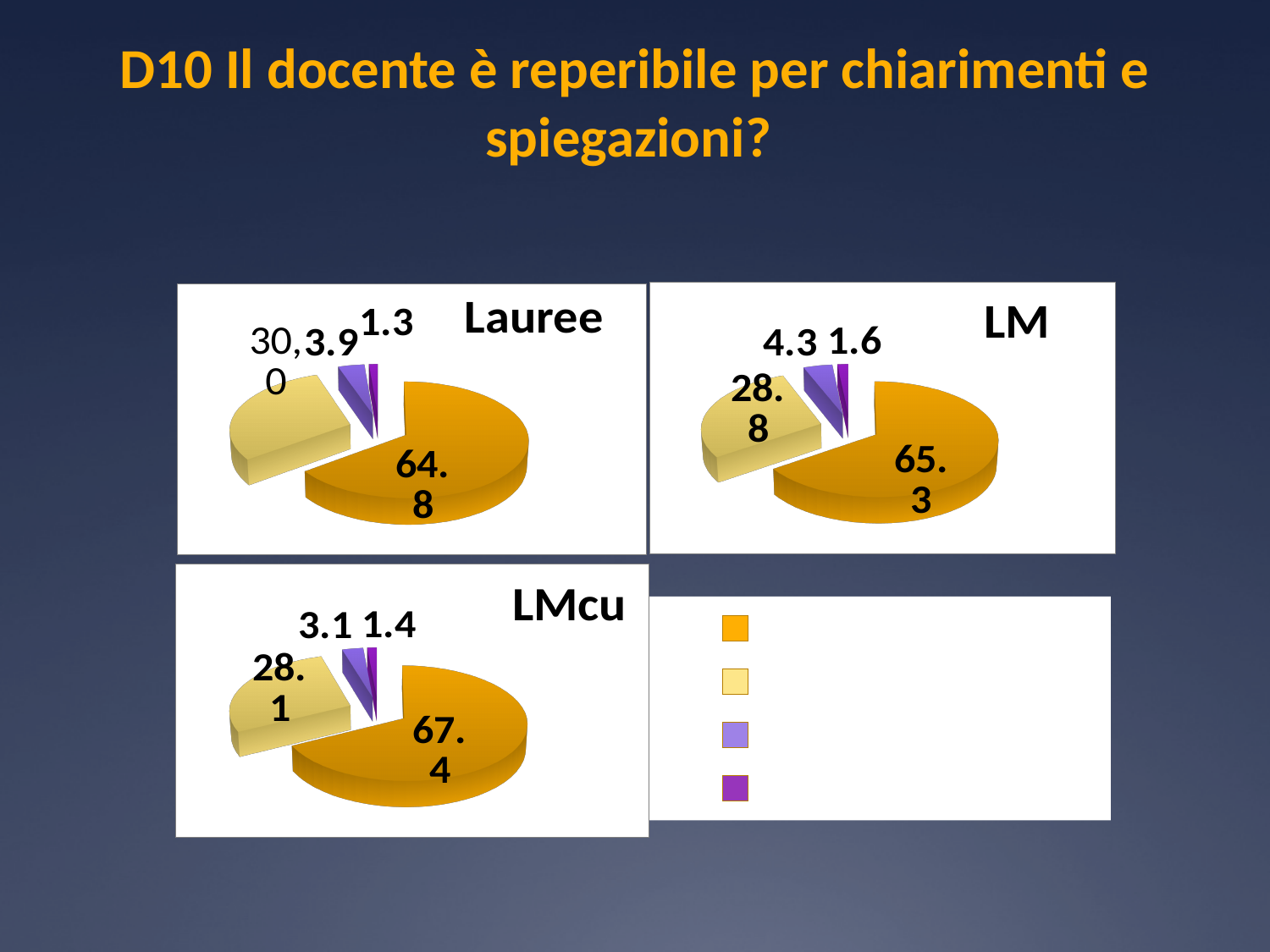
In the LM chart, what is the value of the largest slice? 65.3 In the LMcu chart, what is the value of the smallest slice? 1.4 In the LMcu chart, what is the value of the light yellow slice? 28.1 In the Lauree chart, what is the value of the largest slice? 64.8 In the LM chart, what is the value of the smallest slice? 1.6 How many slices does the LM pie chart have? 4 In the Lauree chart, what is the value of the smallest slice? 1.3 In the LM chart, what is the value of the light yellow slice? 28.8 In the LM chart, what is the difference between the largest slice and the light yellow slice? 36.5 What kind of chart is the Lauree chart? pie chart How many pie charts are shown on the slide? 3 In the LMcu chart, what is the value of the largest slice? 67.4